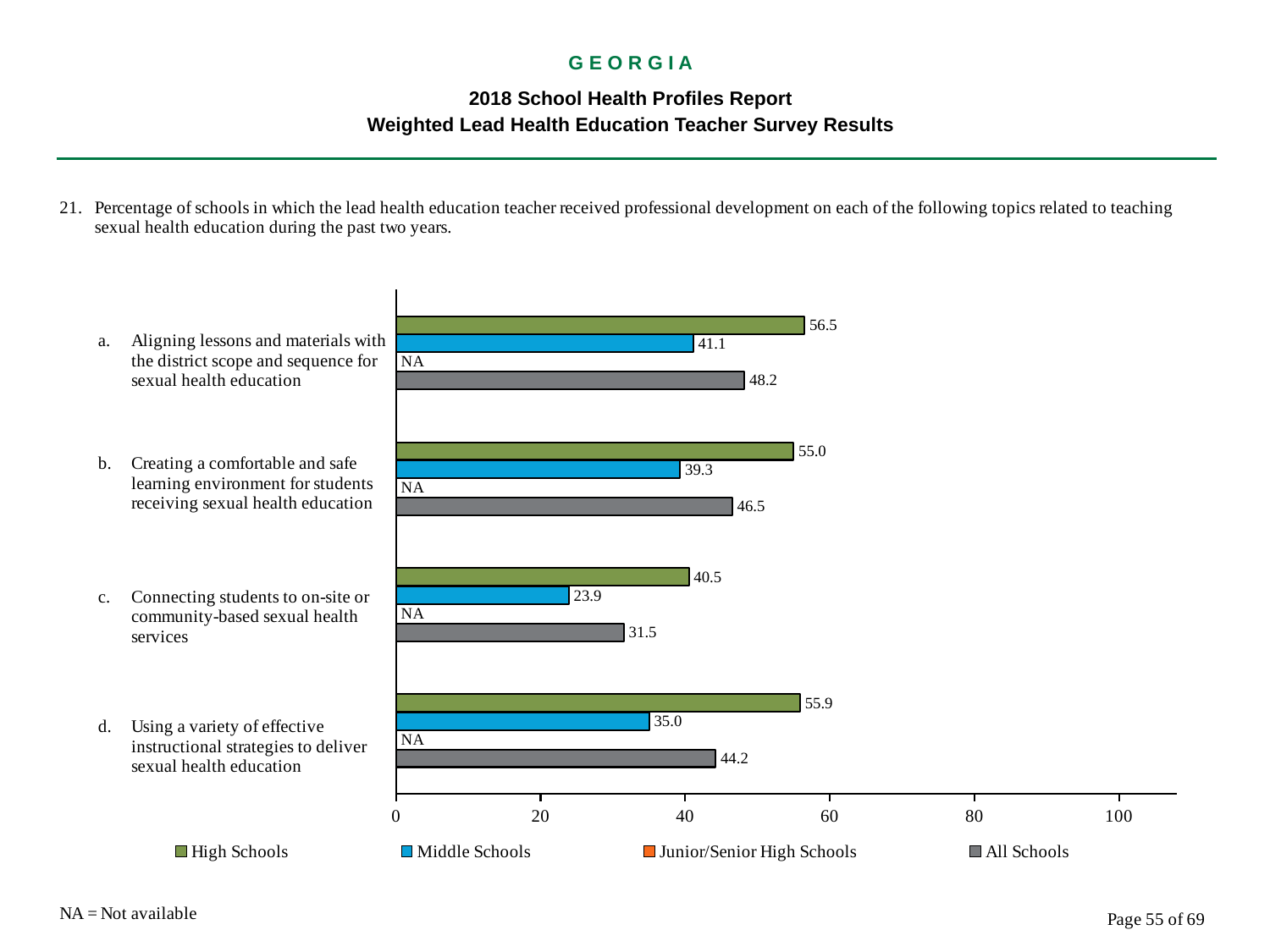
Which topic has the highest High Schools value? a. Aligning lessons and materials with the district scope and sequence for sexual health education Which is larger for topic b: the High Schools value or the All Schools value? High Schools What value is shown for Junior/Senior High Schools for topic b, creating a comfortable and safe learning environment? NA How many topics are listed on the chart? 4 What is the difference between the High Schools and Middle Schools values for topic d, using a variety of effective instructional strategies? 20.9 What is the Middle Schools value for topic c, connecting students to on-site or community-based sexual health services? 23.9 Is the Middle Schools value for topic a greater or less than 40? greater What kind of chart is shown on the slide? bar chart How many series does the legend list? 4 What is the High Schools value for topic a, aligning lessons and materials with the district scope and sequence for sexual health education? 56.5 What is the All Schools value for topic d, using a variety of effective instructional strategies to deliver sexual health education? 44.2 Which topic has the lowest All Schools value? c. Connecting students to on-site or community-based sexual health services